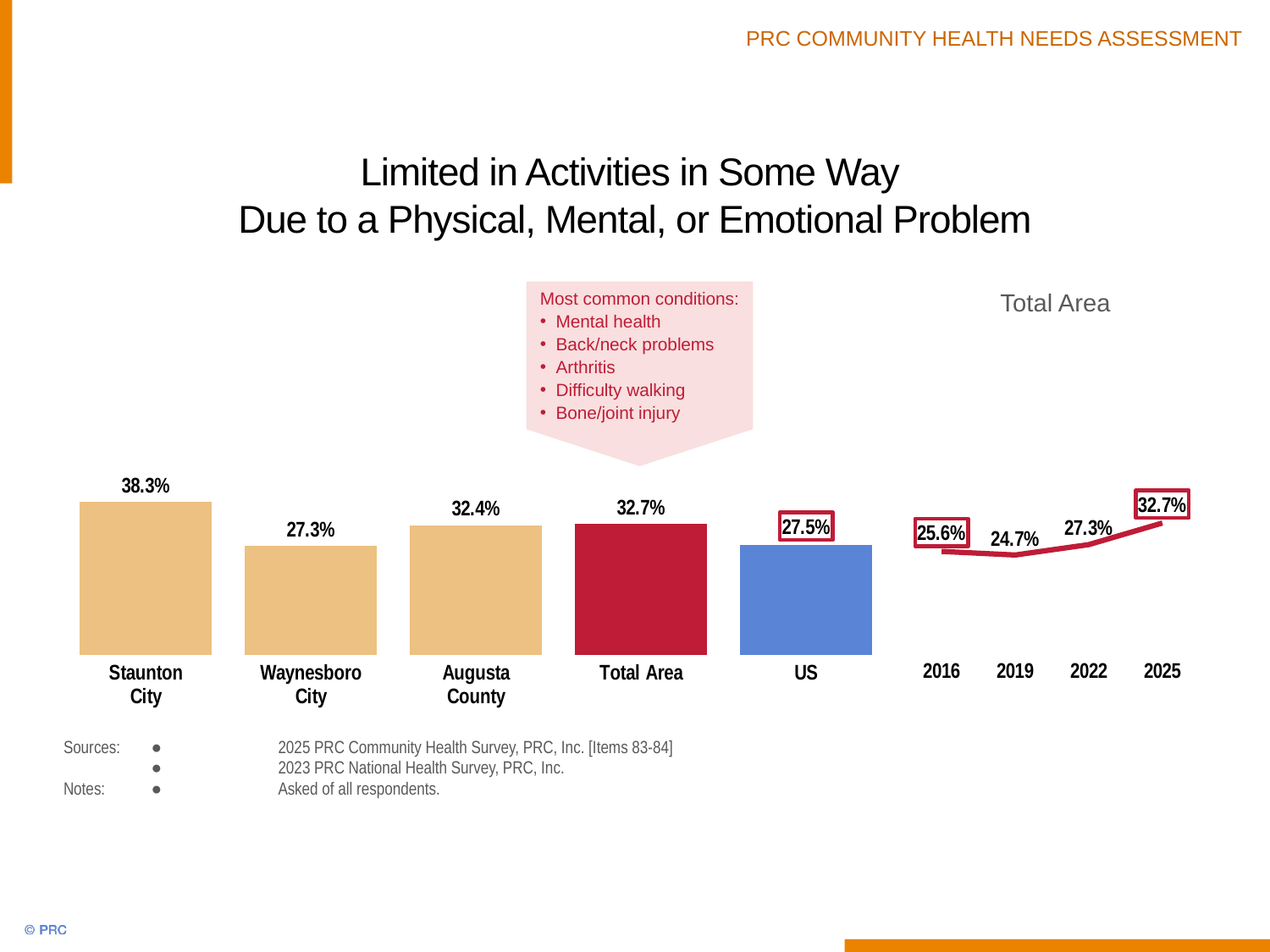
In the bar chart, which is larger, the Total Area value or the US value? Total Area In the bar chart, which category has the lowest value? Waynesboro City In the bar chart, what is the value for Staunton City? 38.3% In the Total Area trend chart, what is the difference between the 2025 and 2016 values? 7.1% In the Total Area trend chart, which year has the lowest value? 2019 In the bar chart, which category has the highest value? Staunton City How many categories are shown in the bar chart? 5 In the bar chart, what is the value for Waynesboro City? 27.3% In the bar chart, what is the value for the US? 27.5% In the Total Area trend chart, what is the value for 2019? 24.7% In the Total Area trend chart, do the values rise or fall from 2019 to 2025? rise In the bar chart, what is the difference between Staunton City and Augusta County? 5.9%